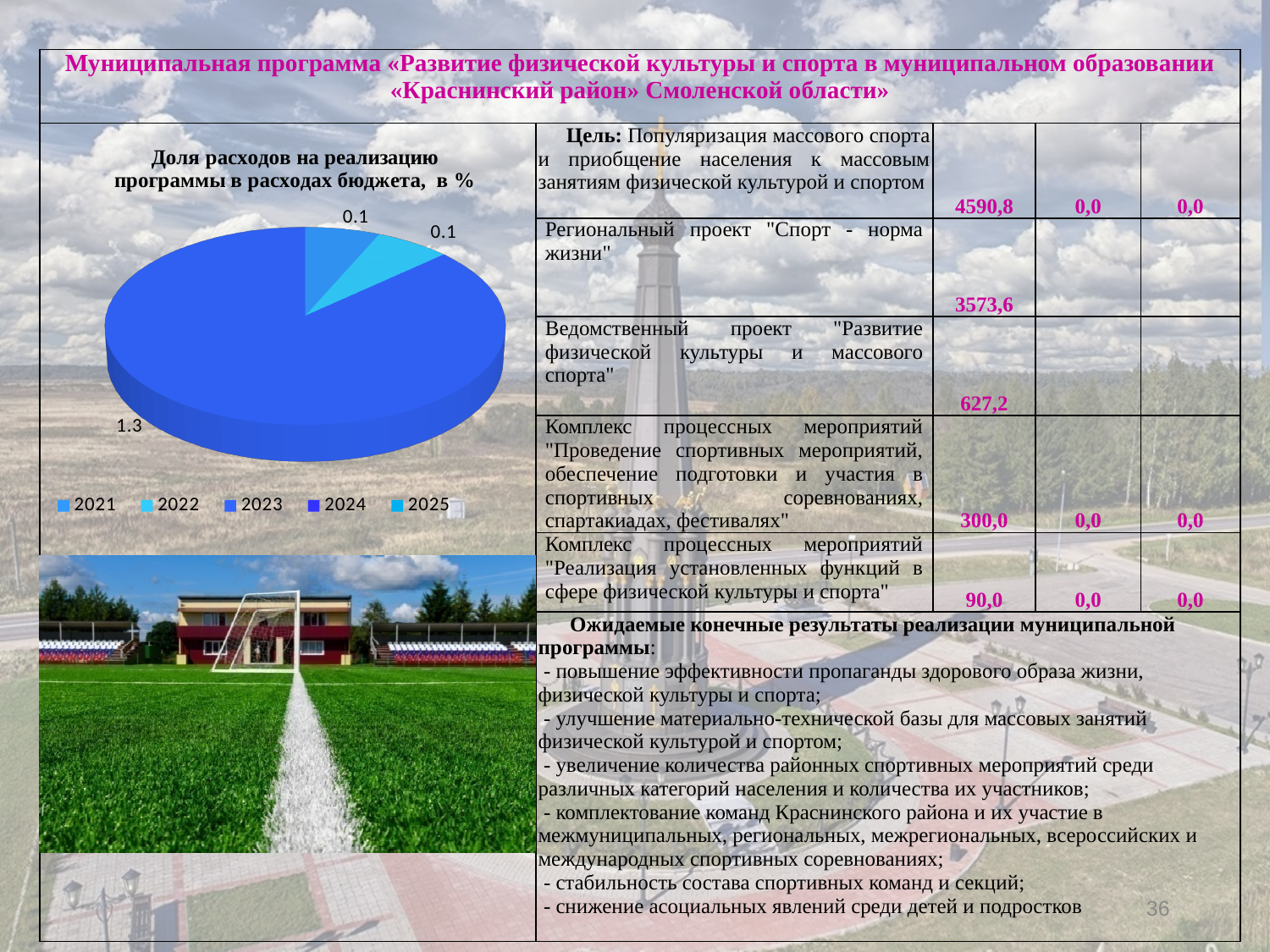
Which year does the legend of the pie chart list first? 2021 What is the difference between the largest labelled slice (1.3) and one of the small slices (0.1) on the pie chart? 1.2 Is the largest slice of the pie chart larger than the two small slices combined? yes What is the smallest value labelled on the pie chart? 0.1 Which year does the legend of the pie chart list last? 2025 What kind of chart is shown on the left of the slide? pie chart What is the largest value labelled on the pie chart? 1.3 What is the title of the pie chart? Доля расходов на реализацию программы в расходах бюджета, в % How many data labels are printed on the pie chart? 3 How many entries does the legend of the pie chart list? 5